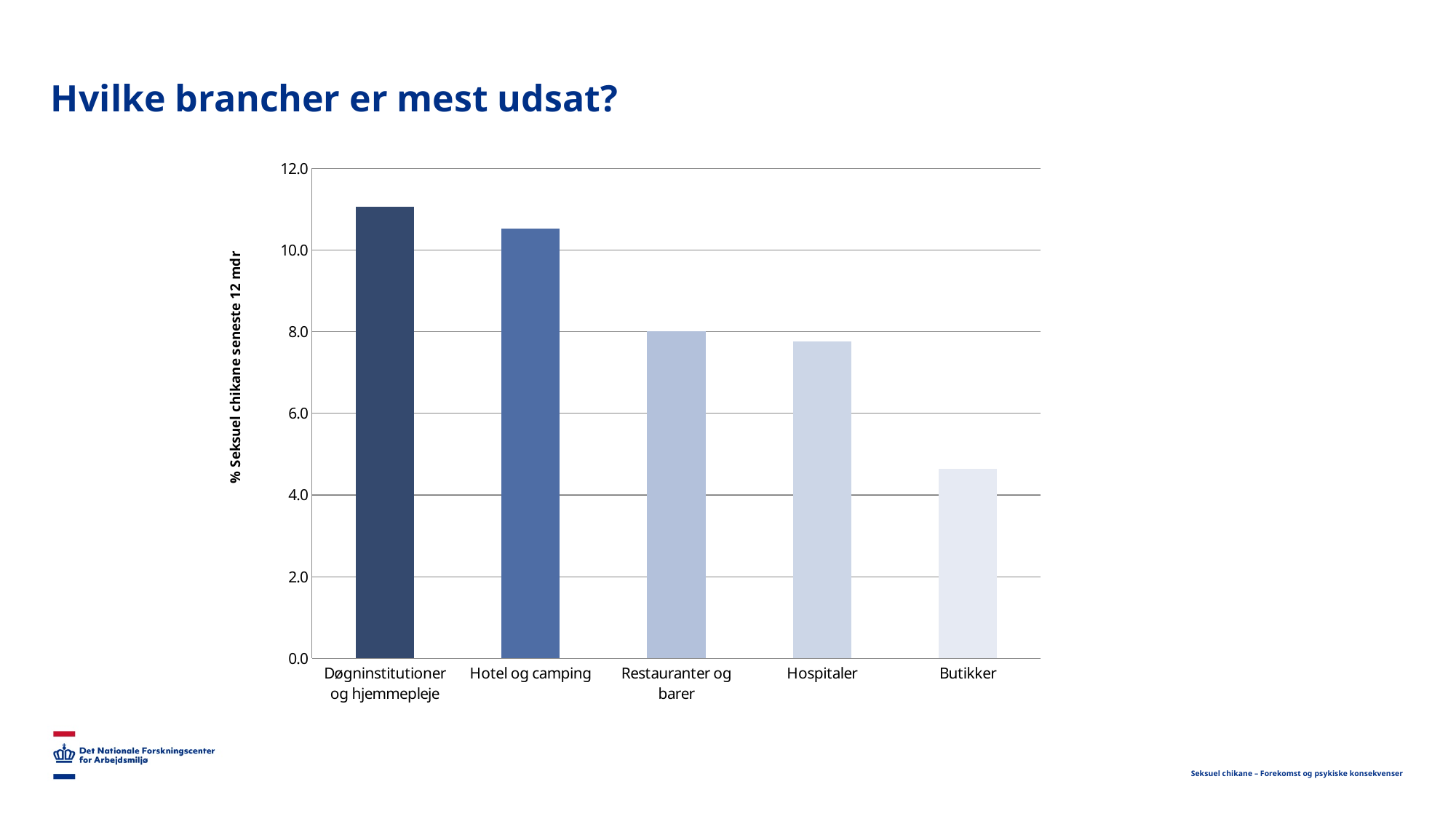
Is the value for Butikker greater or less than 4.0? greater Is the value for Hotel og camping greater or less than 10.0? greater Is the value for Hospitaler greater or less than 8.0? less What is the label on the vertical axis of the chart? % Seksuel chikane seneste 12 mdr What kind of chart is shown on the slide? bar chart Which industry has the highest value? Døgninstitutioner og hjemmepleje Which is larger, the value for Hotel og camping or the value for Restauranter og barer? Hotel og camping How many industry categories are shown on the x axis? 5 Which industry has the lowest value? Butikker Do the values rise or fall from left to right along the x axis? fall